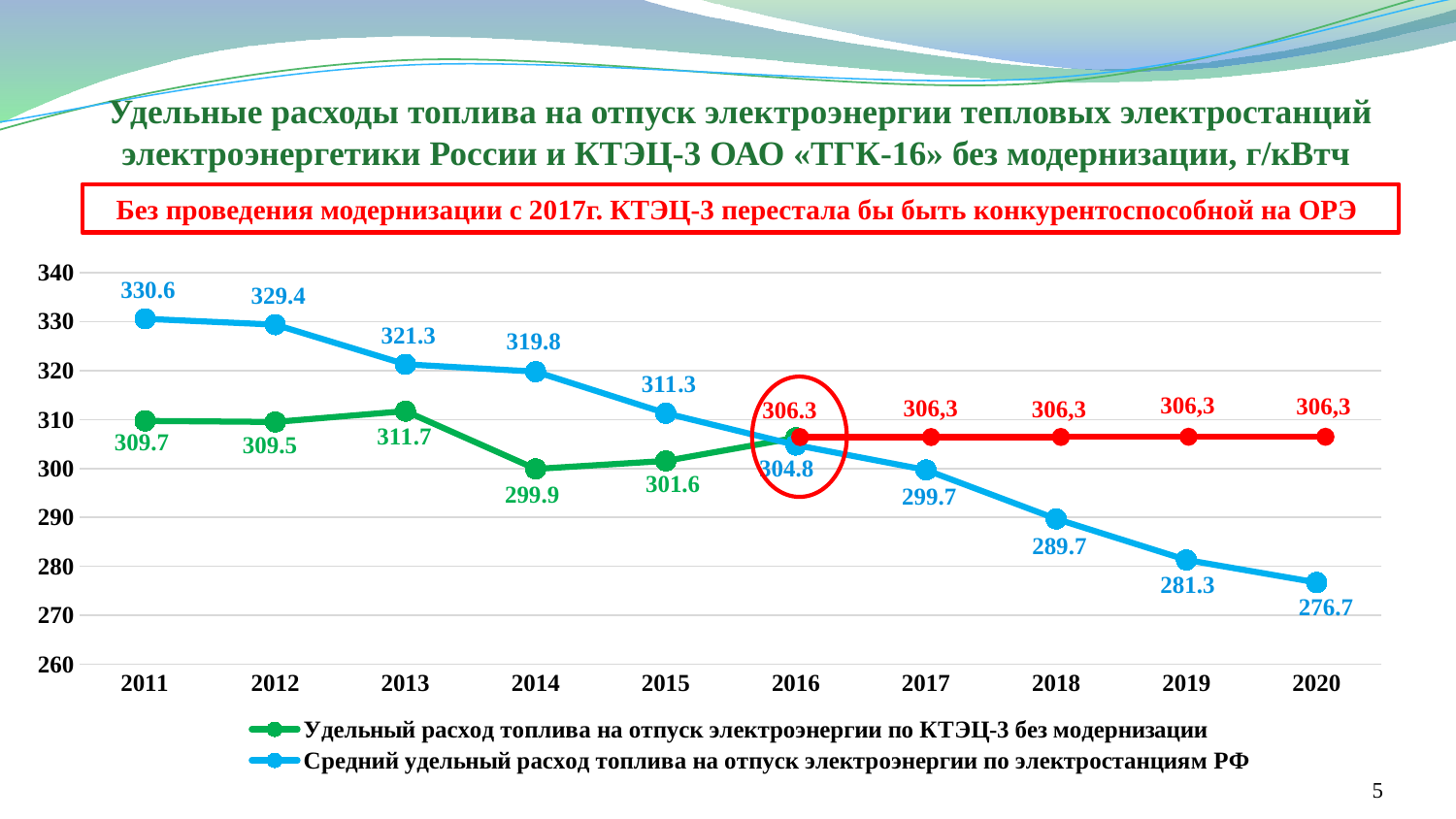
By how much did the blue line (average for RF power plants) decrease from 2011 to 2012? 1.2 What is the value for КТЭЦ-3 without modernization (green line) in 2014? 299.9 What is the average specific fuel consumption for Russian power plants (blue line) in 2011? 330.6 In which year is the КТЭЦ-3 without modernization value (green line) lowest? 2014 How many years are shown on the x axis? 10 In which year is the average specific fuel consumption for RF power plants (blue line) highest? 2011 By how much did the blue line (average for RF power plants) decrease from 2016 to 2020? 28.1 What kind of chart is shown on the slide? Line chart What value is shown for the red line in 2019? 306,3 In 2013, which is higher: the КТЭЦ-3 value (green line) or the RF average (blue line)? RF average (blue line) What is the value of the blue line (average for RF power plants) in 2020? 276.7 How many series does the legend list? 2